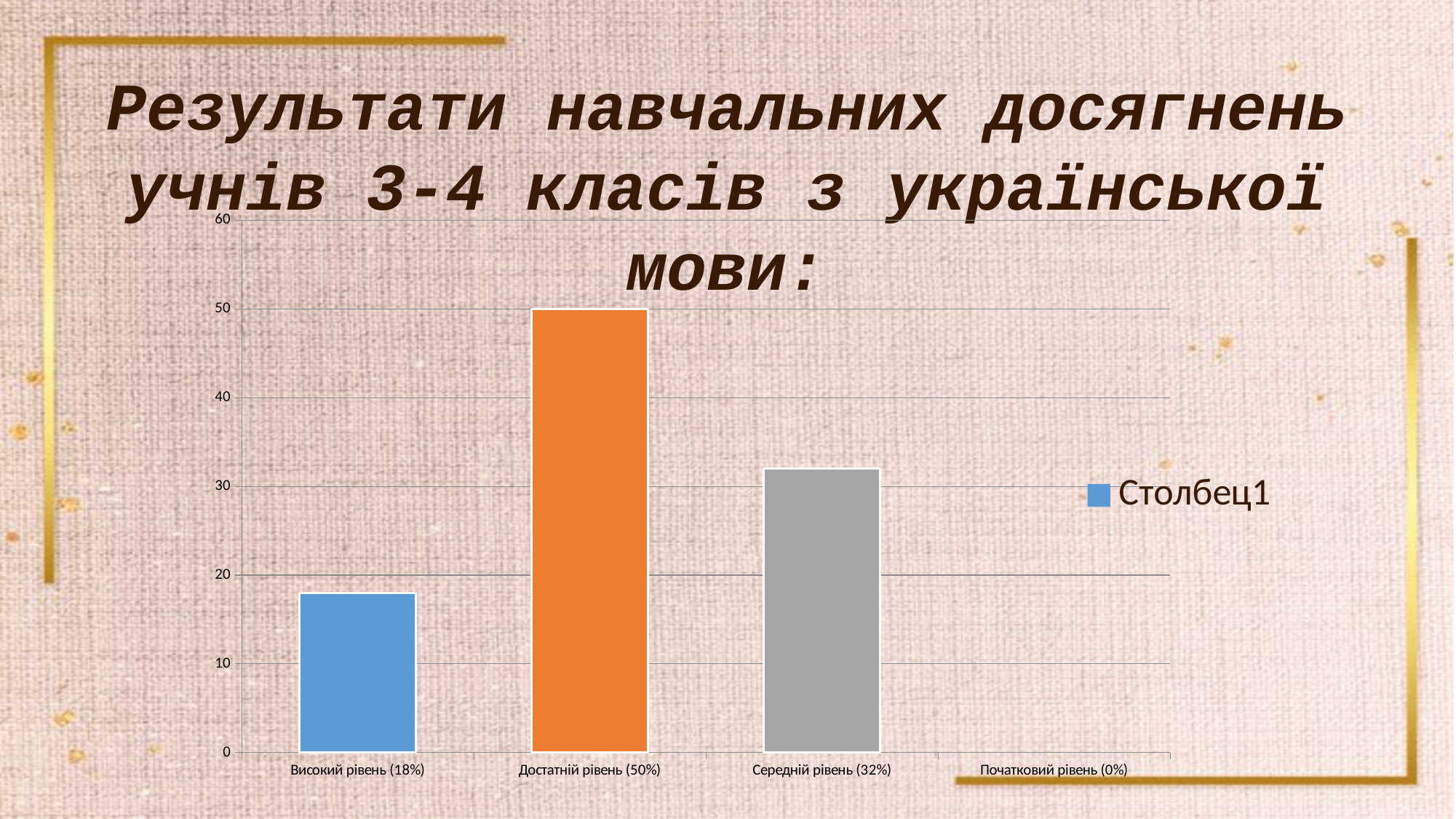
How many series does the chart legend list? 1 What value is shown for Достатній рівень? 50% What is the name of the series in the chart legend? Столбец1 Which category has the lowest value? Початковий рівень How many categories are shown on the x axis of the chart? 4 What value is shown for Початковий рівень? 0% Which is larger, the value for Високий рівень or the value for Середній рівень? Середній рівень Which category has the highest value? Достатній рівень What value is shown for Середній рівень? 32% What value is shown for Високий рівень? 18% What is the difference between the values for Достатній рівень and Середній рівень? 18% What kind of chart is shown on the slide? bar chart